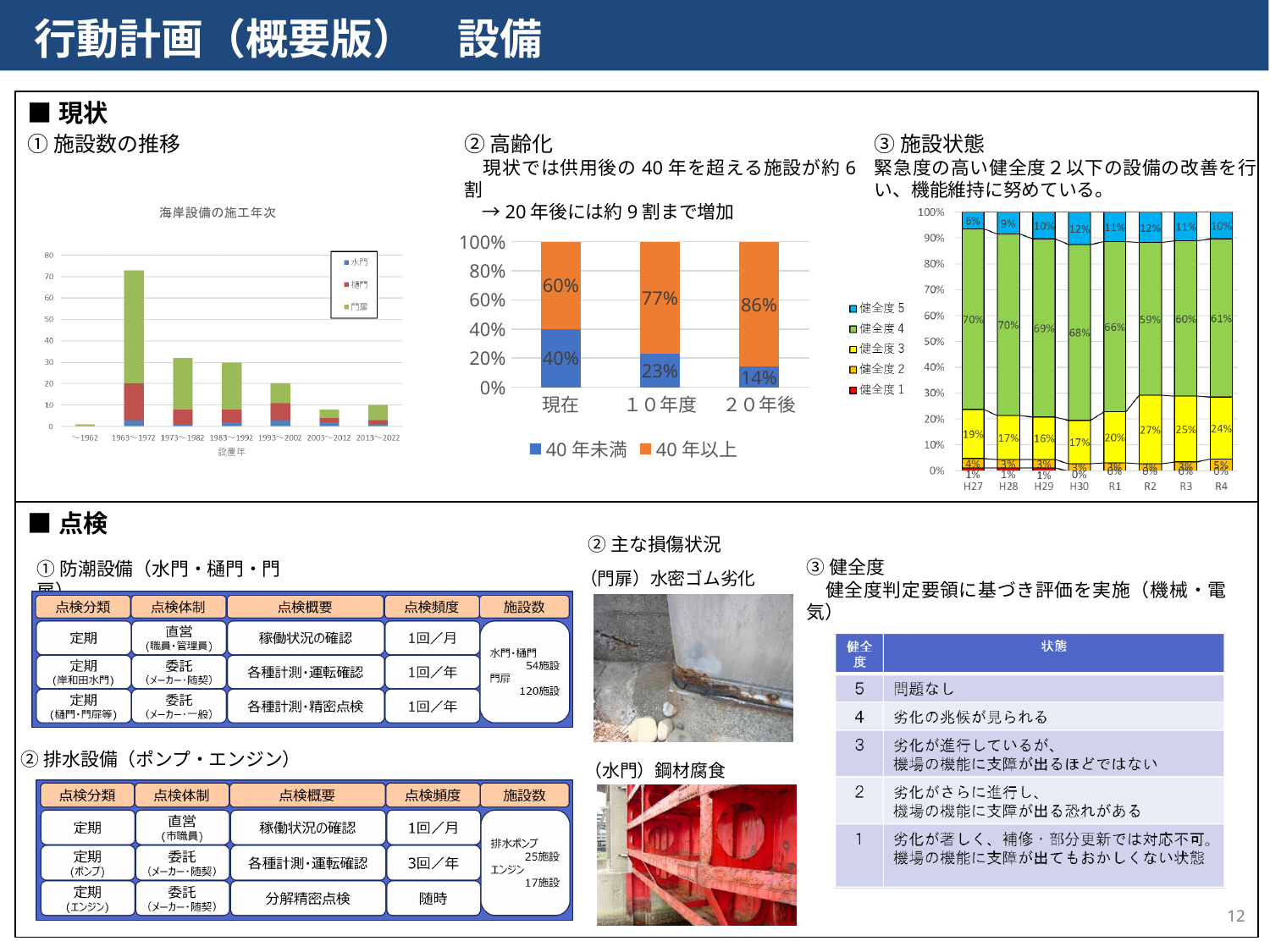
In the 高齢化 chart (middle), what is the value for 40 年未満 at ２０年後? 14% In the 施設状態 chart (right), which year has the highest 健全度 3 value? R2 In the 高齢化 chart (middle), how many series does the legend list? 2 In the 海岸設備の施工年次 chart (left), which 設置年 category has the highest total? 1963～1972 In the 高齢化 chart (middle), what is the value for 40 年以上 at 現在? 60% In the 高齢化 chart (middle), what is the difference between the 40 年以上 values at ２０年後 and 現在? 26% In the 施設状態 chart (right), how many years are shown on the x axis? 8 In the 高齢化 chart (middle), does the 40 年以上 share rise or fall from 現在 to ２０年後? rise In the 施設状態 chart (right), what is the value for 健全度 3 at R2? 27% In the 施設状態 chart (right), how many series does the legend list? 5 In the 施設状態 chart (right), what is the value for 健全度 4 at H27? 70% In the 海岸設備の施工年次 chart (left), is the total for 1963～1972 greater or less than 60? greater